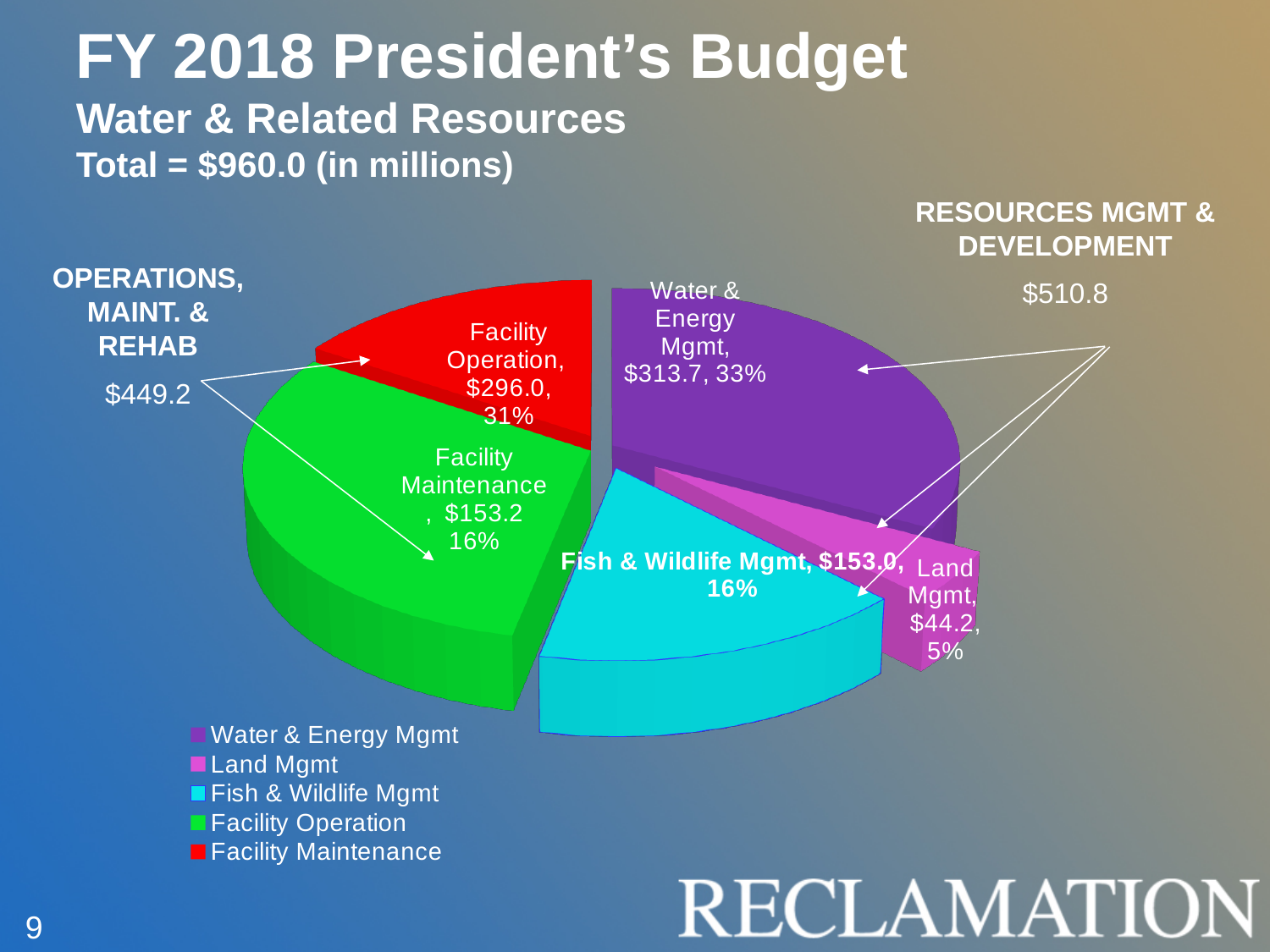
Which is larger, Facility Operation or Fish & Wildlife Mgmt? Facility Operation What kind of chart is shown on the slide? Pie chart What share of the pie does Land Mgmt represent? 5% Which category has the largest slice of the pie chart? Water & Energy Mgmt How many slices does the pie chart have? 5 What is the total for Water & Related Resources stated on the slide? $960.0 (in millions) What is the value for Facility Operation in the pie chart? $296.0 Which category has the smallest slice of the pie chart? Land Mgmt What is the difference between the Water & Energy Mgmt value and the Facility Operation value? $17.7 What is the difference between the Facility Operation value and the Land Mgmt value? $251.8 What is the value for Water & Energy Mgmt in the pie chart? $313.7 What is the value for Fish & Wildlife Mgmt in the pie chart? $153.0